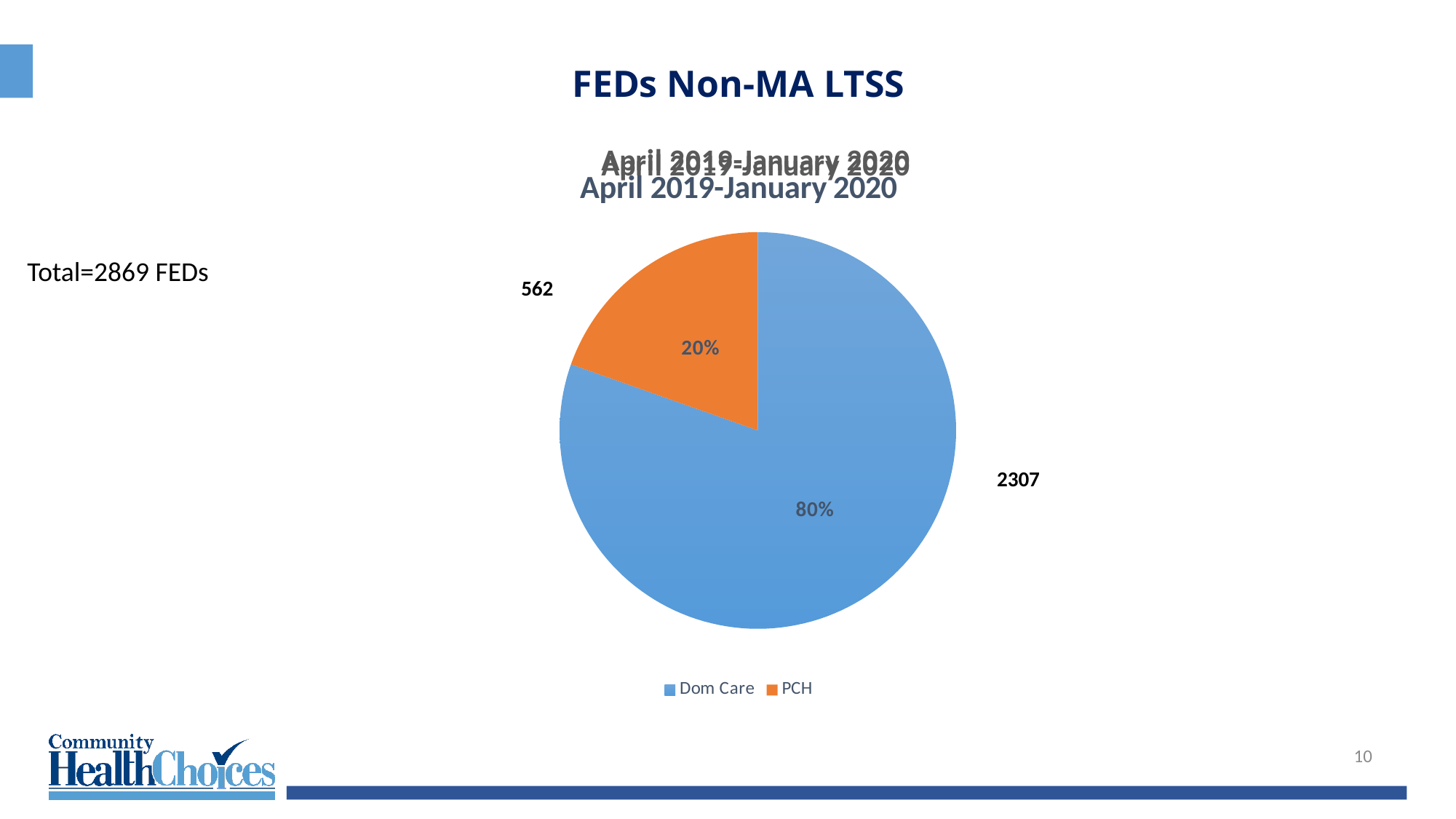
What is the value for PCH? 562 Which is larger, the value for Dom Care or the value for PCH? Dom Care Which category has the smallest slice? PCH What is the difference between the Dom Care and PCH values? 1745 How many entries does the legend list? 2 What is the value for Dom Care? 2307 What share of the pie does PCH represent? 20% What kind of chart is shown on the slide? pie chart What colour is the PCH slice? orange What share of the pie does Dom Care represent? 80% Which category has the largest slice? Dom Care How many slices does the pie chart have? 2